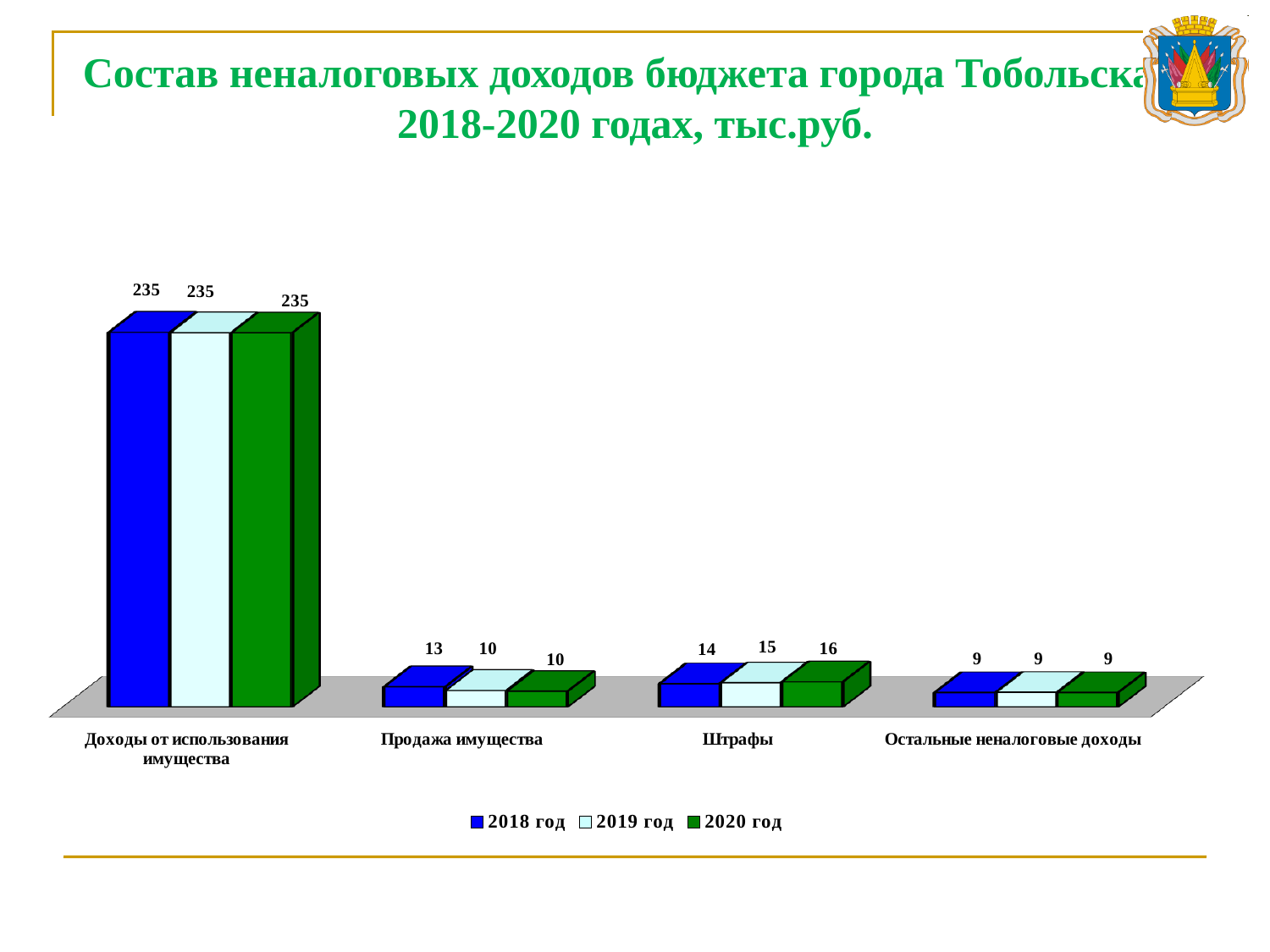
What is the difference between the 2018 год and 2019 год values for Продажа имущества? 3 Which category has the lowest value in 2019 год? Остальные неналоговые доходы Which is larger for Штрафы: the 2018 год value or the 2020 год value? 2020 год What kind of chart is shown on the slide? bar chart What is the value for Остальные неналоговые доходы in 2018 год? 9 What is the difference between the 2018 год and 2020 год values for Штрафы? 2 What is the value for Продажа имущества in 2019 год? 10 Which category has the highest value in 2020 год? Доходы от использования имущества How many series does the legend list? 3 How many categories are shown on the x axis? 4 What is the value for Доходы от использования имущества in 2018 год? 235 What is the value for Штрафы in 2020 год? 16